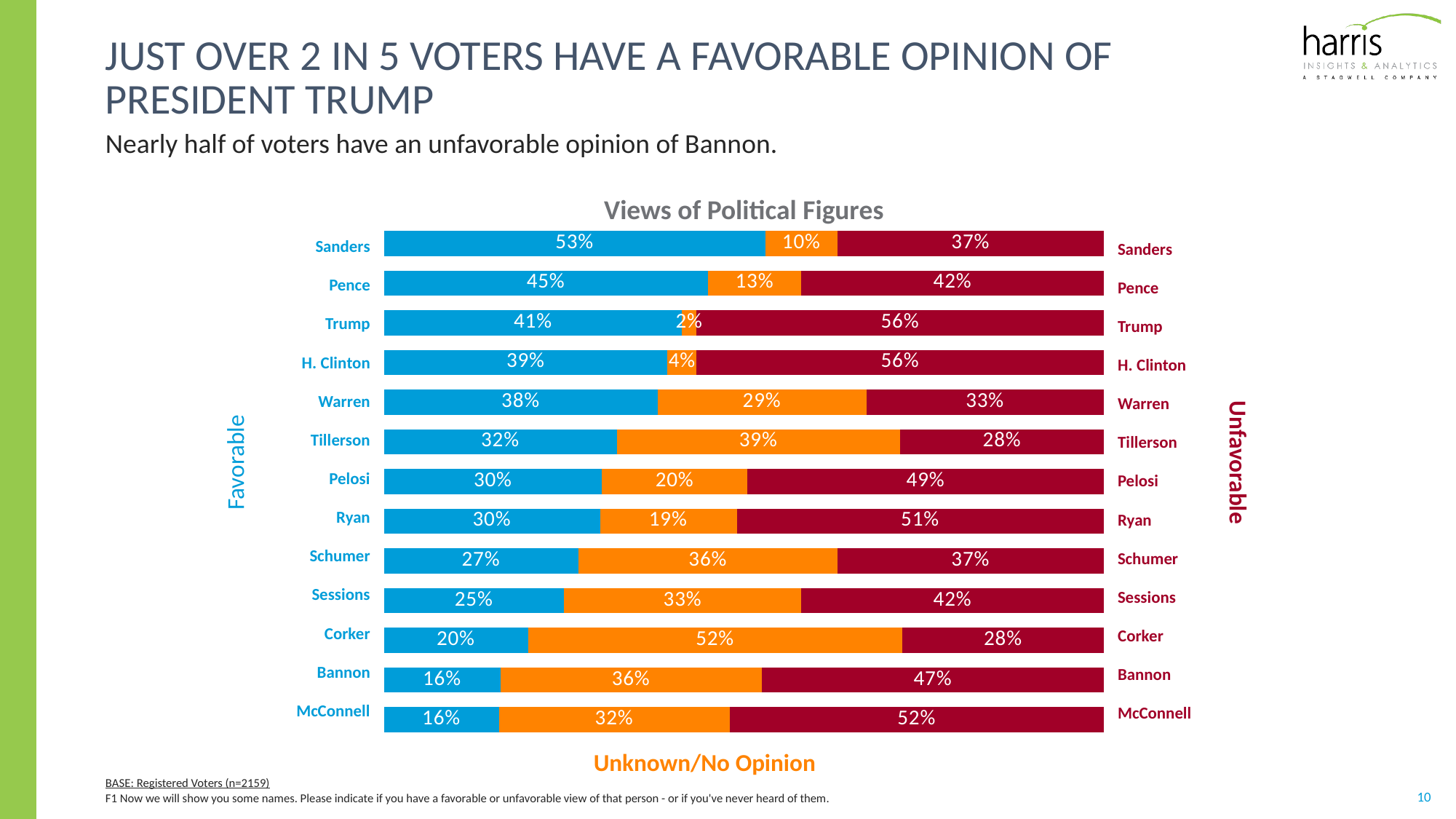
What is the Unknown/No Opinion value for Corker? 52% Which has a larger Unfavorable value, McConnell or Pelosi? McConnell Which political figure has the lowest Unknown/No Opinion percentage? Trump How many series does the chart show? 3 What type of chart is shown on the slide? Stacked bar chart How many percentage points higher is Sanders' Favorable value than Trump's Favorable value? 12 Which political figure has the highest Unknown/No Opinion percentage? Corker What percentage of voters have a favorable opinion of Sanders? 53% What is the Unfavorable value for Trump? 56% Which political figure has the highest Favorable percentage? Sanders What is the Unfavorable value for Bannon? 47% How many political figures are shown in the chart? 13